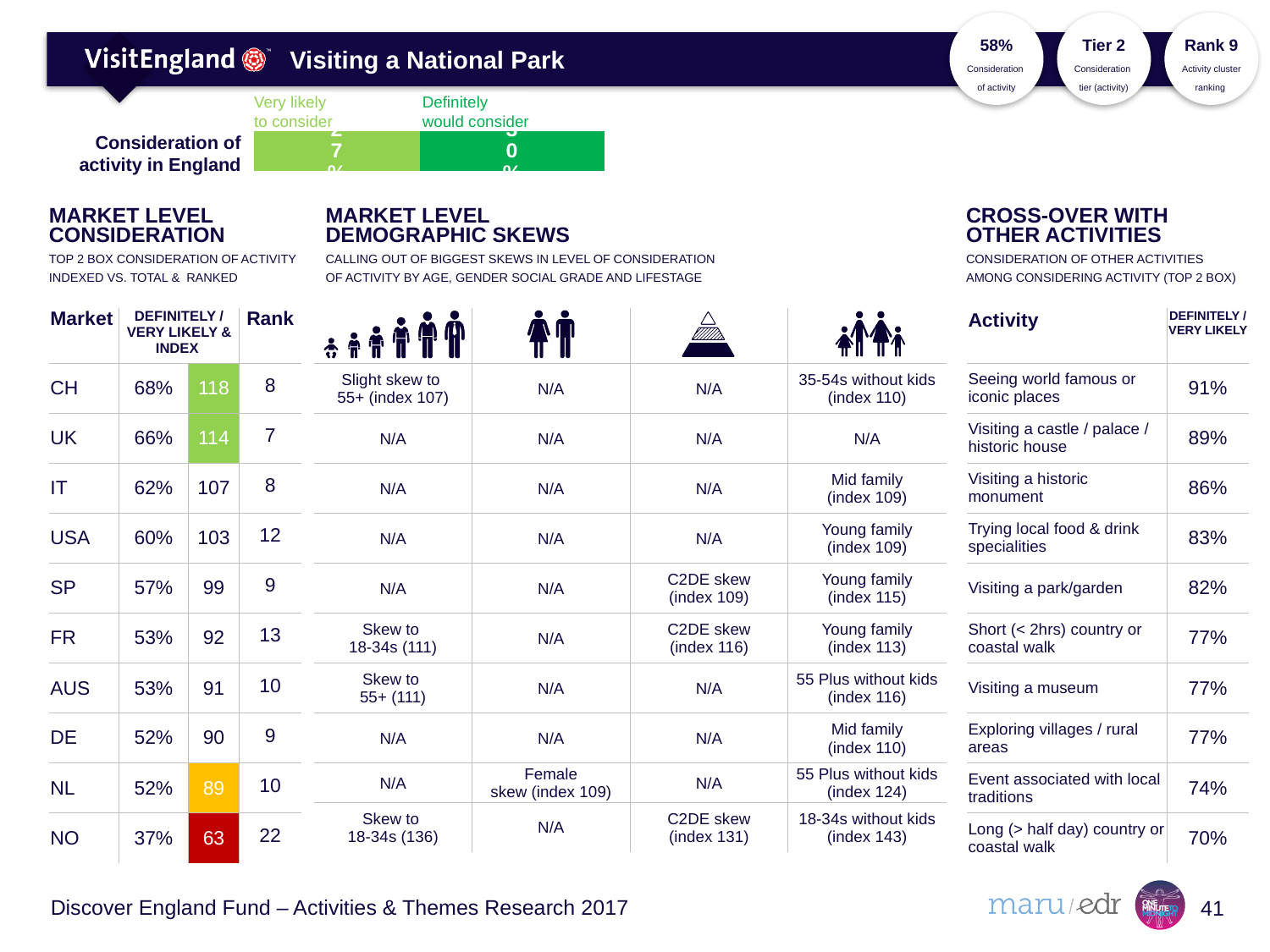
In the 'Consideration of activity in England' chart, which is larger: 'Very likely to consider' or 'Definitely would consider'? Definitely would consider How many series does the legend of the 'Consideration of activity in England' chart list? 2 What kind of chart is shown under 'Consideration of activity in England'? bar chart What are the two legend entries of the 'Consideration of activity in England' chart? Very likely to consider; Definitely would consider In the 'Consideration of activity in England' chart, which colour represents 'Definitely would consider'? dark green How many categories (bars) does the 'Consideration of activity in England' chart show? 1 In the 'Consideration of activity in England' chart, what is the value for 'Very likely to consider'? 27% In the 'Consideration of activity in England' chart, what is the value for 'Definitely would consider'? 30%